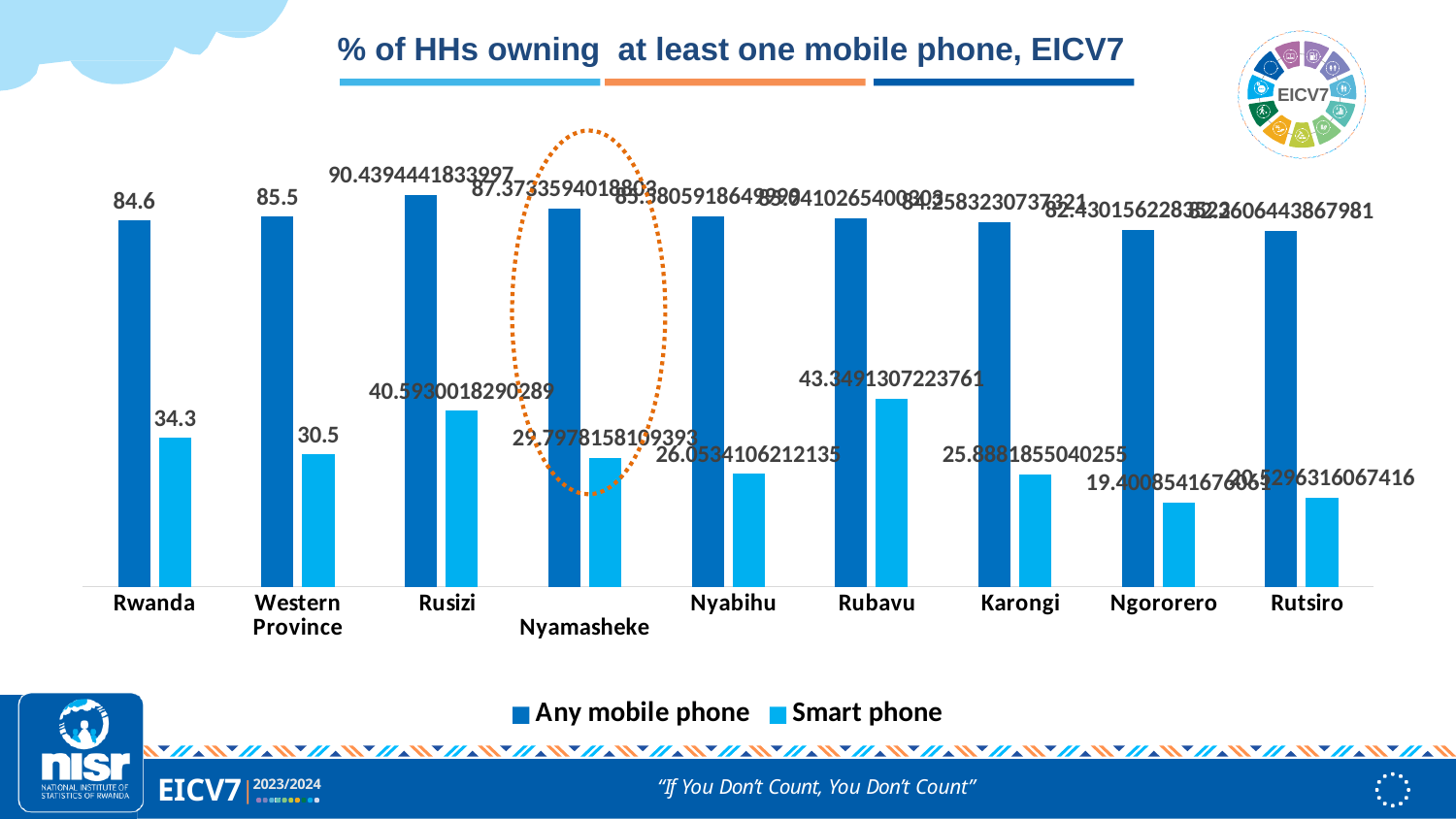
What is the value for Smart phone in Rwanda? 34.3 What type of chart is shown on the slide? Bar chart Which category has the highest value for Smart phone? Rubavu What are the two series named in the legend? Any mobile phone and Smart phone What is the value for Any mobile phone in Western Province? 85.5 Which category has the highest value for Any mobile phone? Rusizi Which is larger, the Smart phone value for Rwanda or for Western Province? Rwanda What is the value for Any mobile phone in Rwanda? 84.6 How many series does the legend list? 2 What is the difference between Any mobile phone and Smart phone in Rwanda? 50.3 How many categories are shown on the x axis? 9 What is the value for Smart phone in Western Province? 30.5